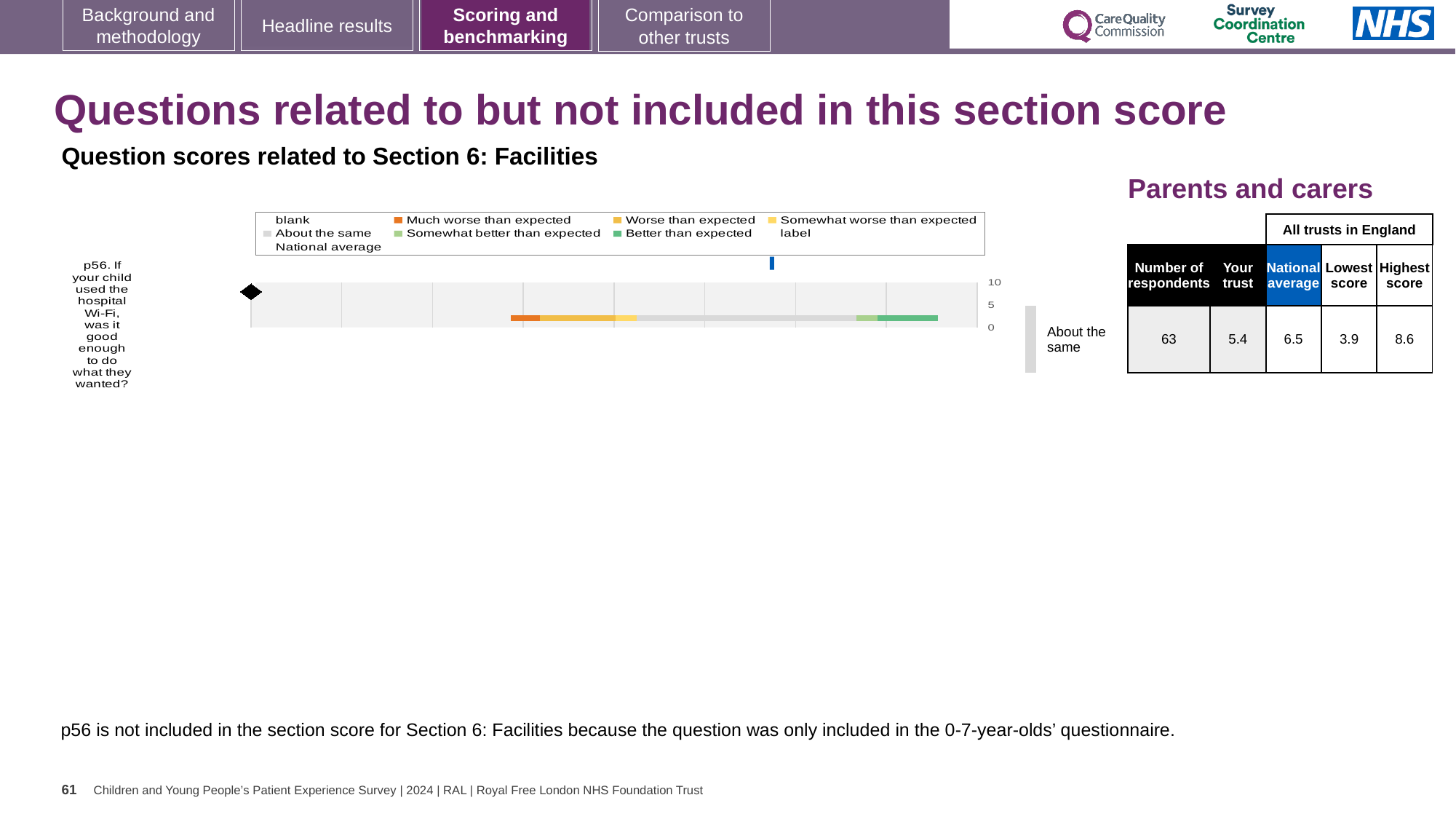
What is the highest score among all trusts in England for p56? 8.6 What benchmark category is the trust's p56 score placed in? About the same What is the 'Your trust' score for p56 (hospital Wi-Fi good enough)? 5.4 What kind of chart is used to show the p56 question score? bar chart What is the highest value shown on the chart's score axis? 10 Which is larger for p56: the trust's score or the national average? national average What is the lowest score among all trusts in England for p56? 3.9 What is the difference between the highest and lowest trust scores for p56? 4.7 What is the national average score for p56? 6.5 How many respondents answered p56? 63 By how much does the national average exceed the trust's score for p56? 1.1 How many questions are plotted in the chart? 1